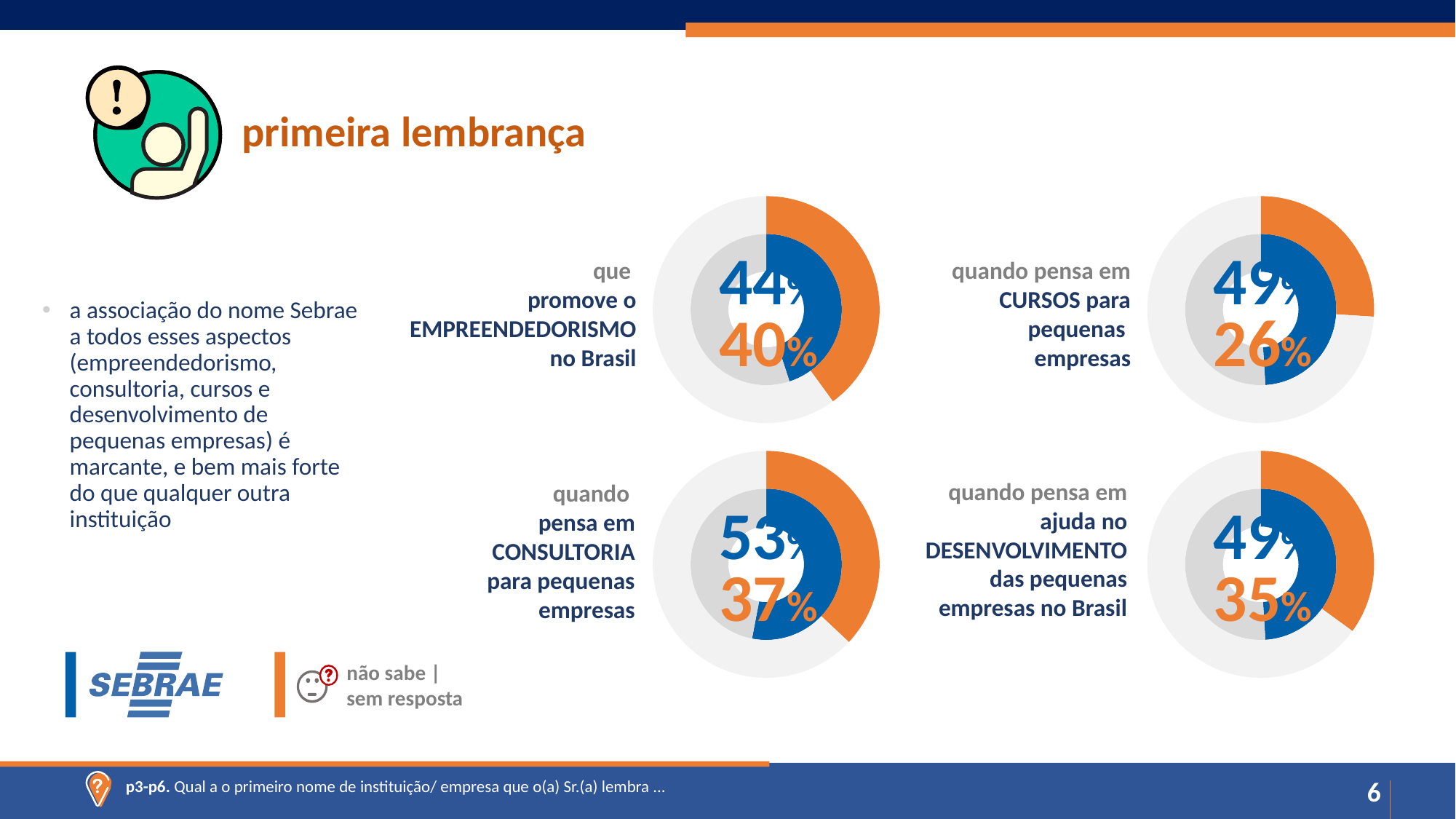
Across the four donut charts, which topic has the lowest orange value? CURSOS para pequenas empresas What kind of chart is used to display the percentages on this slide? Donut (pie) chart Across the four donut charts, which topic has the highest blue value? CONSULTORIA para pequenas empresas In the chart labelled 'quando pensa em ajuda no DESENVOLVIMENTO das pequenas empresas no Brasil', what is the orange value? 35% Which is larger: the orange value for EMPREENDEDORISMO or the orange value for DESENVOLVIMENTO das pequenas empresas? EMPREENDEDORISMO In the chart labelled 'que promove o EMPREENDEDORISMO no Brasil', what is the value shown in blue? 44% How many donut charts are shown on the slide? 4 In the chart labelled 'que promove o EMPREENDEDORISMO no Brasil', what is the value shown in orange? 40% In the chart labelled 'quando pensa em CONSULTORIA para pequenas empresas', what is the difference between the blue and orange values? 16 percentage points In the chart labelled 'quando pensa em CURSOS para pequenas empresas', what is the difference between the blue value and the orange value? 23 percentage points In the chart labelled 'quando pensa em CURSOS para pequenas empresas', what is the orange value? 26% In the chart labelled 'quando pensa em CONSULTORIA para pequenas empresas', what is the blue value? 53%